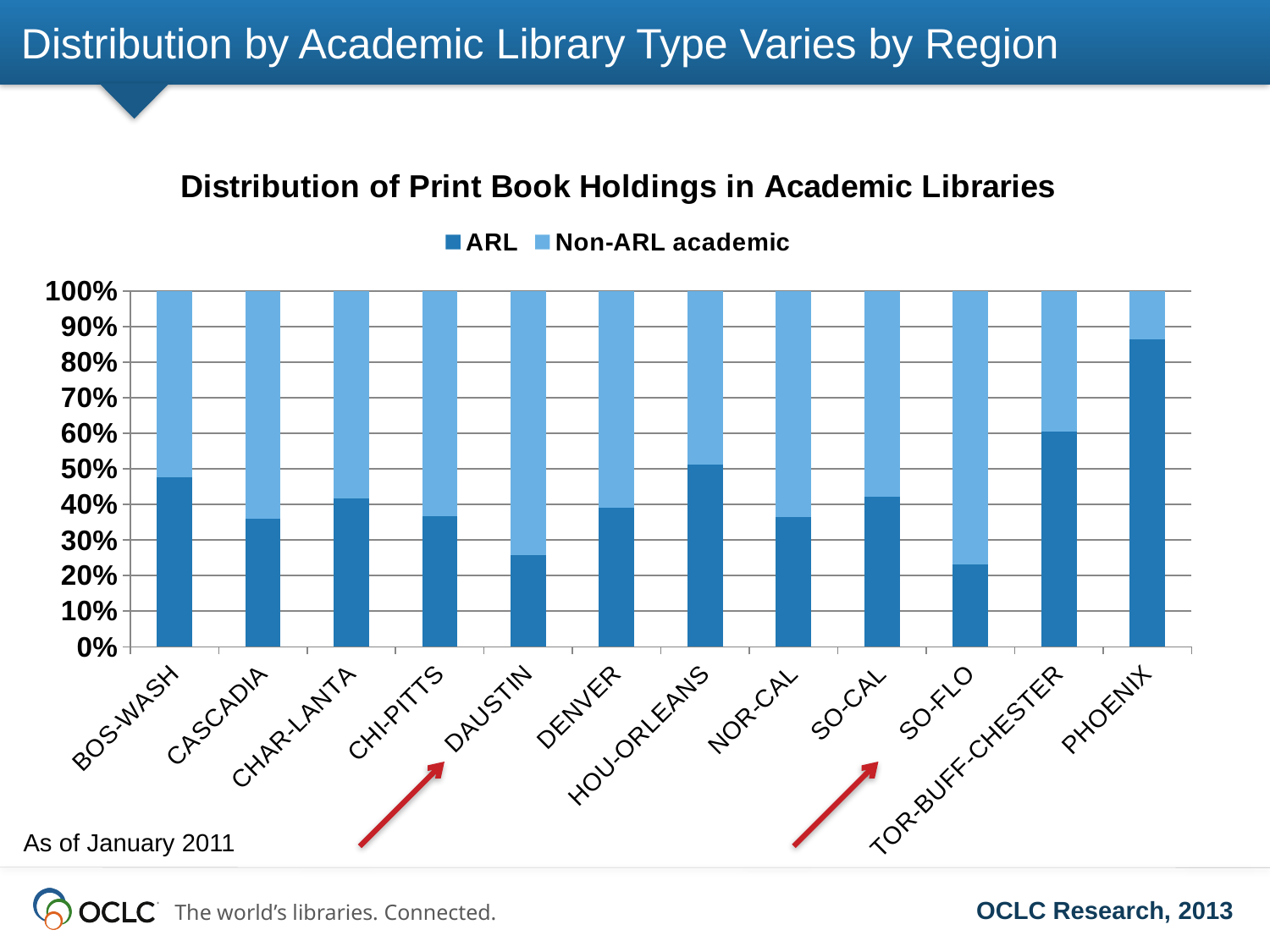
Is the ARL share for PHOENIX greater or less than 80%? greater What is the title of the chart? Distribution of Print Book Holdings in Academic Libraries How many series does the chart's legend list? 2 Is the ARL share for DAUSTIN greater or less than 30%? less What kind of chart is shown on the slide? Stacked bar chart Which region has the largest Non-ARL academic share? SO-FLO Which region has the highest ARL share of print book holdings? PHOENIX Is the ARL share for TOR-BUFF-CHESTER greater or less than 50%? greater Which region has a larger ARL share, TOR-BUFF-CHESTER or DENVER? TOR-BUFF-CHESTER How many regions are shown on the x axis of the chart? 12 Which region has the lowest ARL share of print book holdings? SO-FLO What is the total of the stacked bar for CASCADIA? 100%